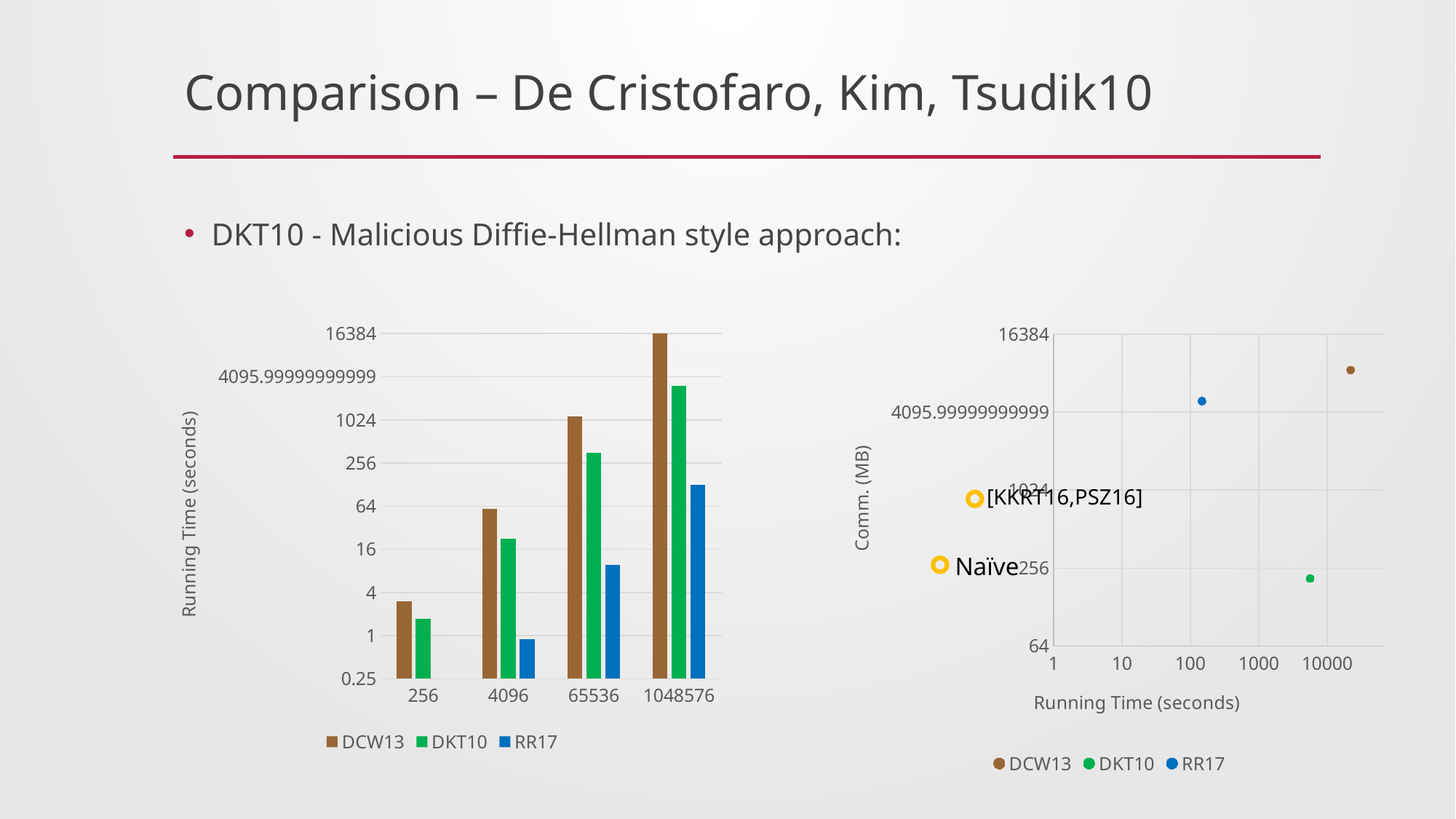
What is the y-axis label of the right chart? Comm. (MB) In the left bar chart, is the running time for RR17 at 1048576 greater or less than 64? greater In the left bar chart, which series has the lowest running time at 4096? RR17 How many categories are shown on the x axis of the left bar chart? 4 In the left bar chart, is the running time for DKT10 at 4096 greater or less than 16? greater In the right chart, which series has the highest communication (MB)? DCW13 In the left bar chart, which is larger at 65536: DCW13 or RR17? DCW13 In the left bar chart, does the running time for DCW13 rise or fall as the set size increases along the x axis? rise In the left bar chart, which series has the highest running time at 1048576? DCW13 What type of chart is the left chart on the slide? bar chart In the left bar chart, is the running time for RR17 at 65536 greater or less than 16? less How many series does the legend of the left bar chart list? 3